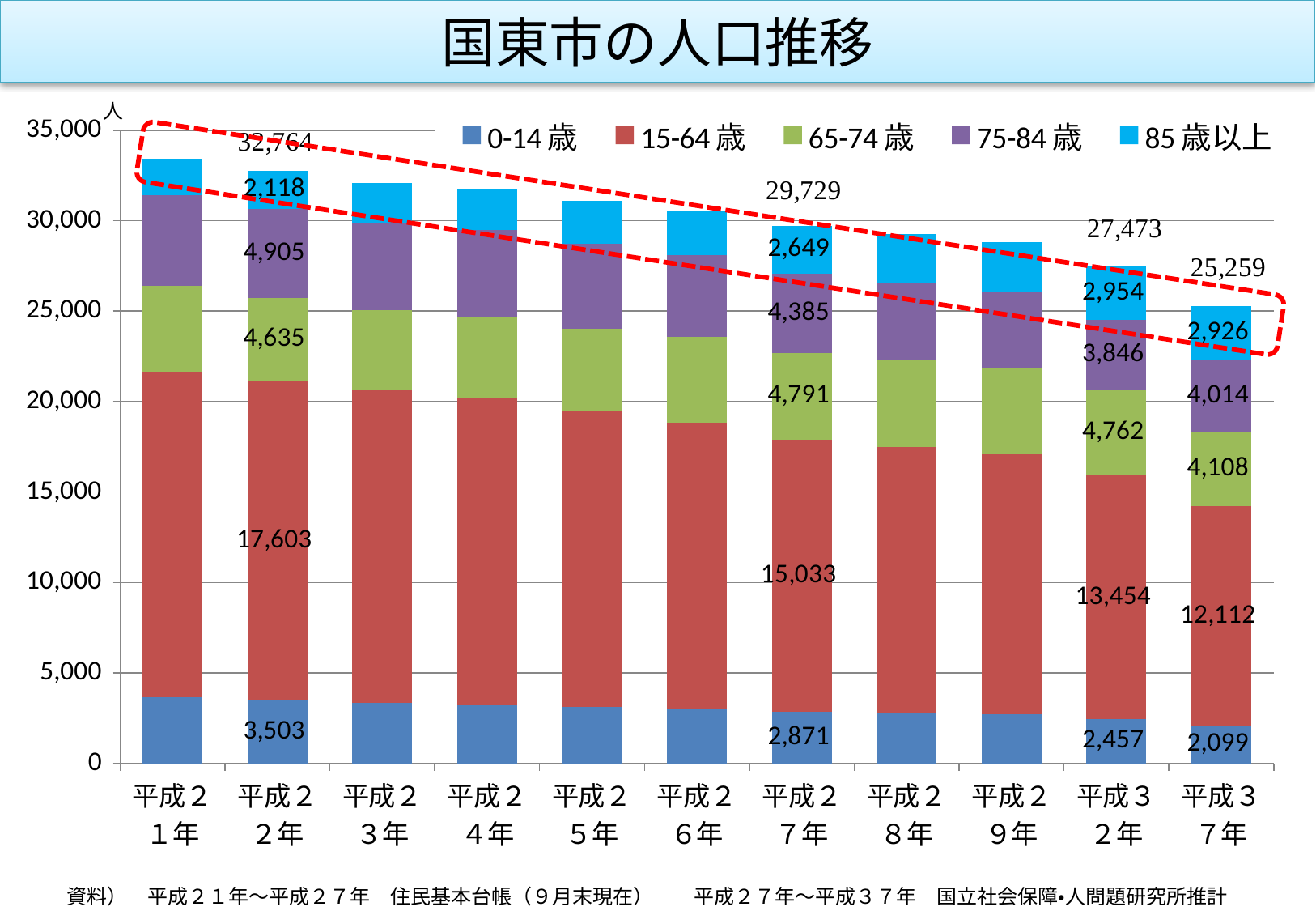
What is the value for the 15-64歳 series in 平成22年? 17,603 How many years (bars) are shown on the x axis? 11 What is the value for the 85歳以上 series in 平成32年? 2,954 What is the difference between the 15-64歳 values for 平成22年 and 平成37年? 5,491 Do the total bar heights rise or fall from 平成21年 to 平成37年? Fall What is the title of the chart? 国東市の人口推移 Which is larger in 平成27年: the 65-74歳 value or the 75-84歳 value? 65-74歳 What is the value for the 0-14歳 series in 平成37年? 2,099 What kind of chart is shown on the slide? Stacked bar chart Is the total for 平成21年 greater or less than 30,000? greater What is the total population shown for 平成27年? 29,729 How many series does the legend list? 5